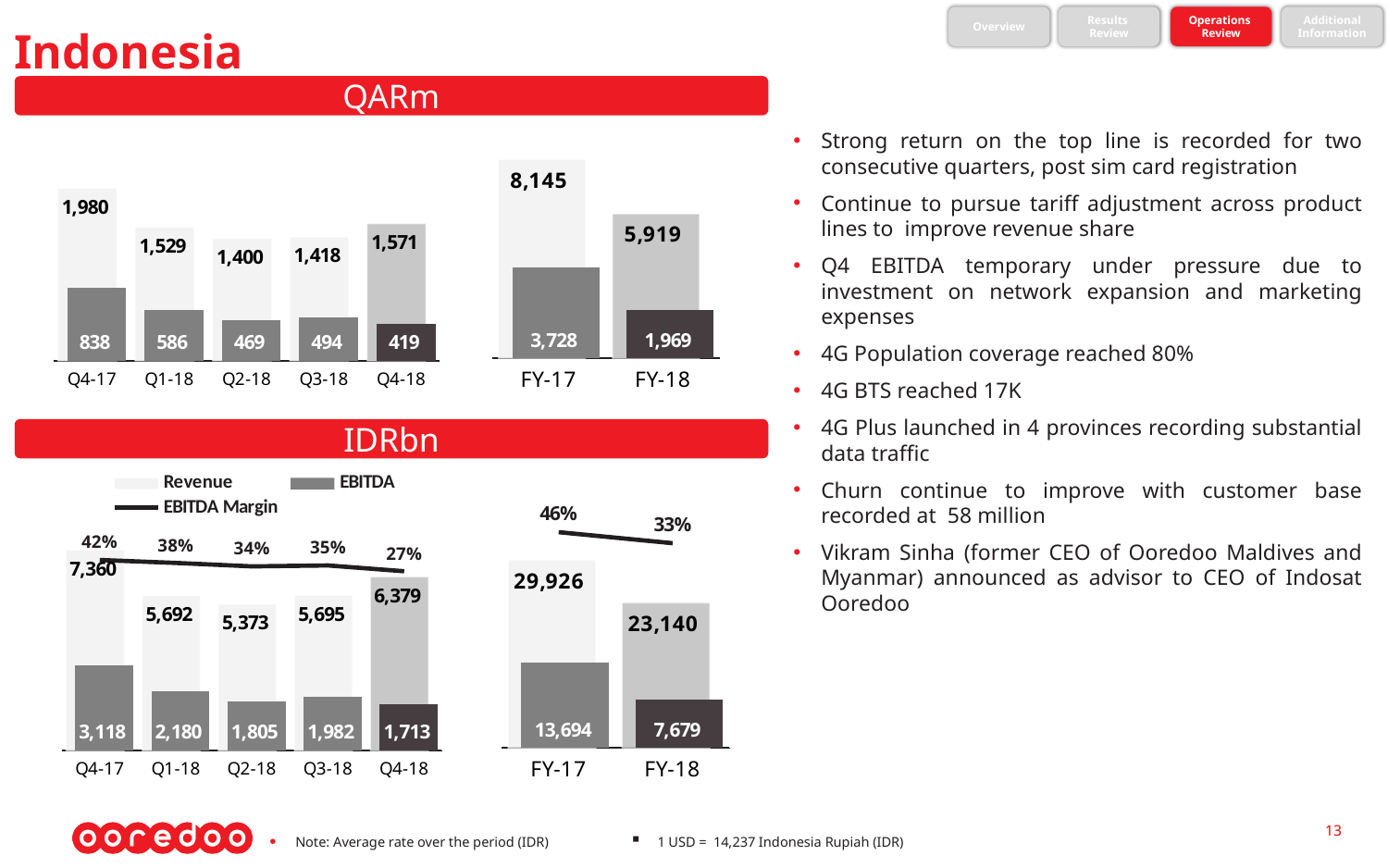
In the QARm chart, which quarter has the highest EBITDA? Q4-17 In the IDRbn chart, what is the difference between Q4-17 EBITDA and Q4-18 EBITDA? 1,405 In the QARm chart, which quarter has the lowest revenue? Q2-18 In the IDRbn chart, what is the revenue value for FY-17? 29,926 In the QARm chart, what is the revenue value for Q4-18? 1,571 In the QARm chart, what is the EBITDA value for FY-18? 1,969 In the IDRbn chart, which is larger: EBITDA for Q1-18 or EBITDA for Q3-18? Q1-18 In the IDRbn chart, what is the EBITDA margin for Q4-18? 27% In the IDRbn chart, does the EBITDA margin rise or fall from FY-17 to FY-18? fall In the QARm chart, what is the difference between FY-17 revenue and FY-18 revenue? 2,226 What kind of chart is used to show revenue and EBITDA in the QARm chart? bar chart How many series does the legend of the IDRbn chart list? 3